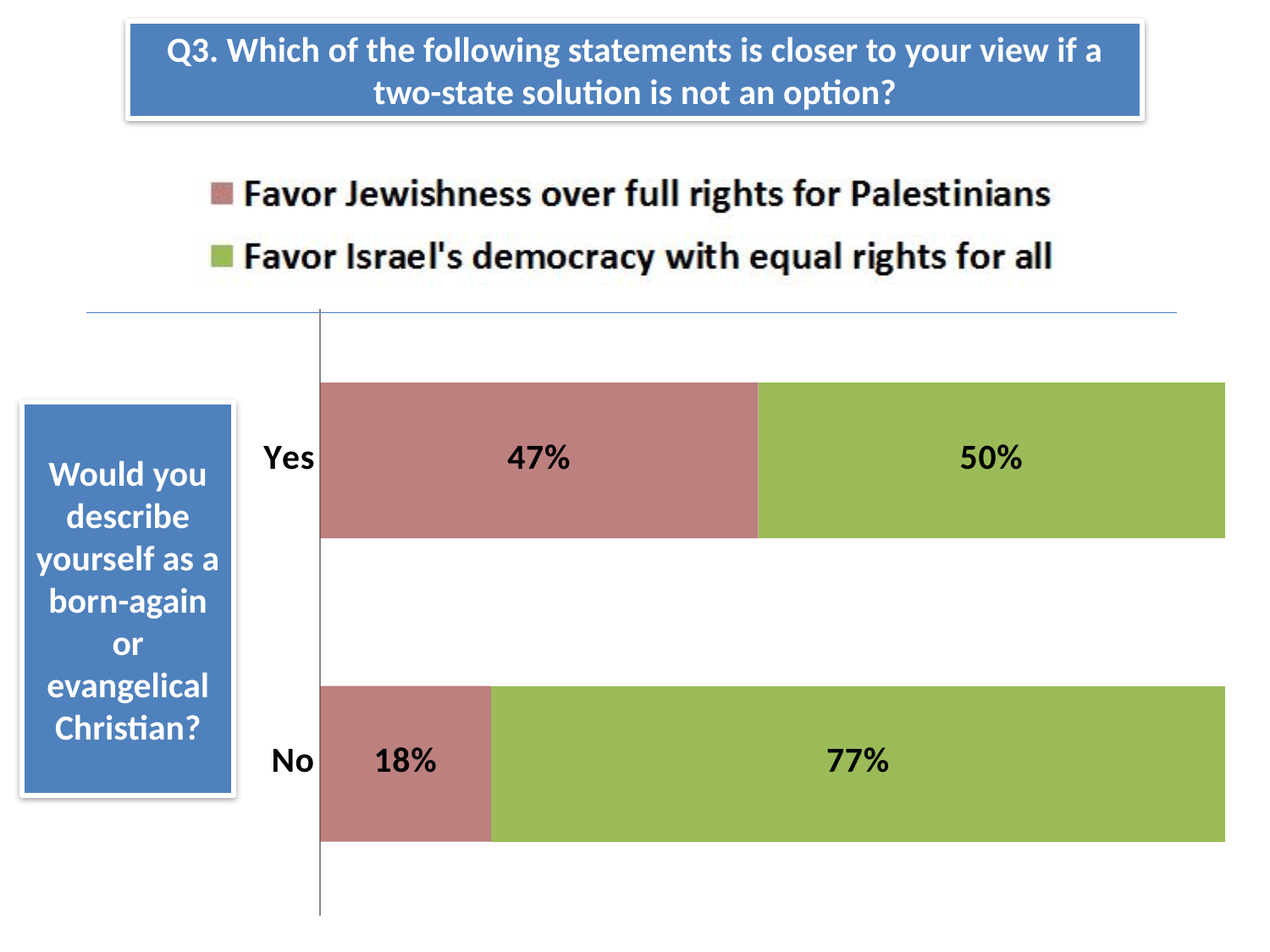
What kind of chart is shown on the slide? Stacked bar chart What is the difference between the 'No' group's and the 'Yes' group's share favoring Israel's democracy with equal rights for all? 27% What is the difference between the 'Yes' group's and the 'No' group's share favoring Jewishness over full rights for Palestinians? 29% How many categories are shown on the chart? 2 How many series does the legend list? 2 What percentage of the 'No' group favors Israel's democracy with equal rights for all? 77% What percentage of the 'Yes' group favors Jewishness over full rights for Palestinians? 47% What is the total of the two labeled segments in the 'No' bar? 95% What percentage of the 'No' group favors Jewishness over full rights for Palestinians? 18% Which group has the higher share favoring Israel's democracy with equal rights for all, 'Yes' or 'No'? No Which group has the lower share favoring Jewishness over full rights for Palestinians? No What percentage of the 'Yes' group favors Israel's democracy with equal rights for all? 50%